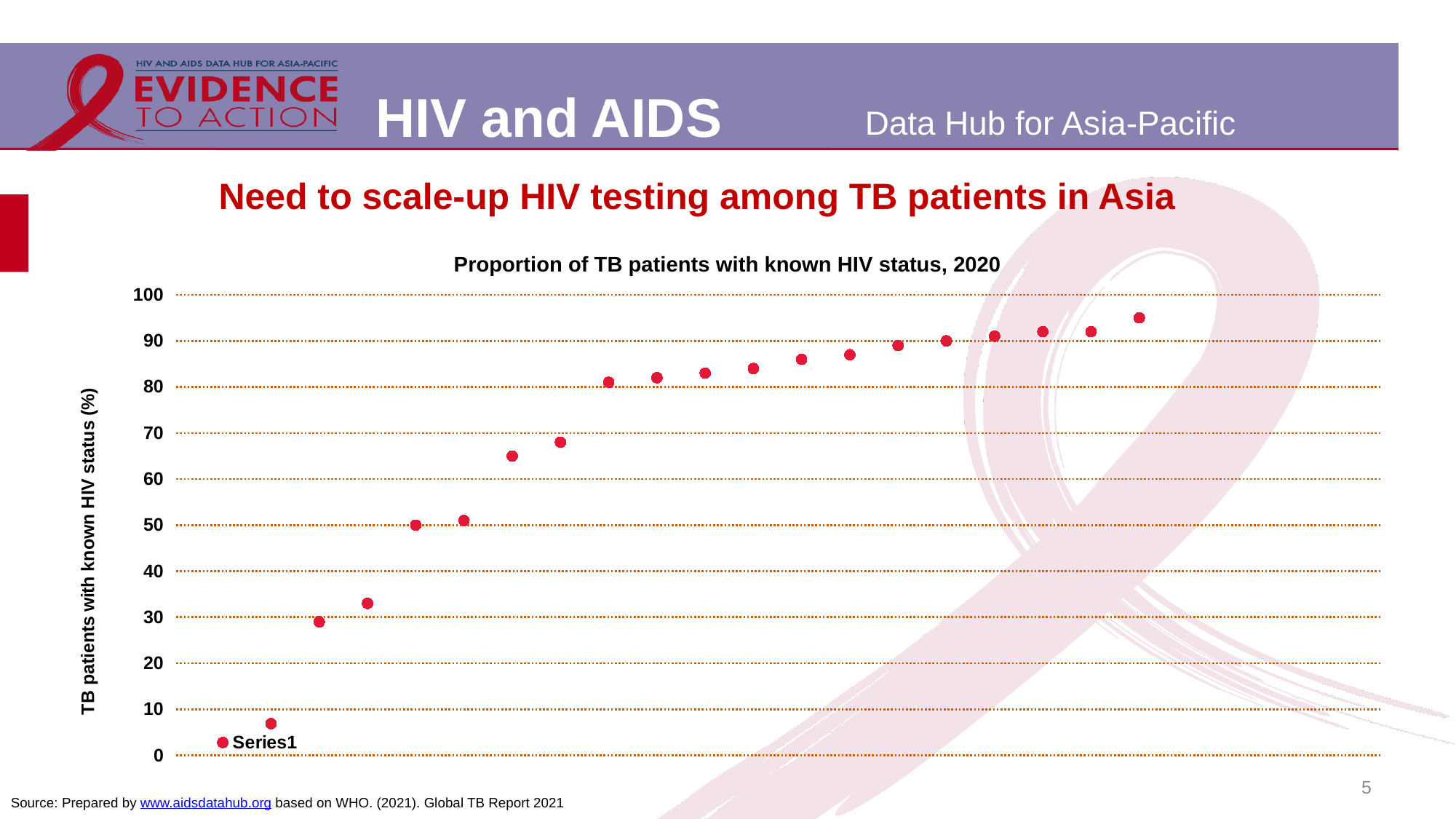
How many series does the chart legend list? 1 Is the value of the lowest (leftmost) point greater or less than 10? less What is the maximum value shown on the vertical axis? 100 What is the name of the series shown in the legend? Series1 What is the title of the chart? Proportion of TB patients with known HIV status, 2020 Is the value of the second point from the left greater or less than 20? less Do the plotted values rise or fall from left to right along the x axis? Rise What kind of chart is shown on the slide? Scatter chart How many data points are plotted in the chart? 20 Is the value of the highest (rightmost) point greater or less than 90? greater What is the label of the vertical axis? TB patients with known HIV status (%)